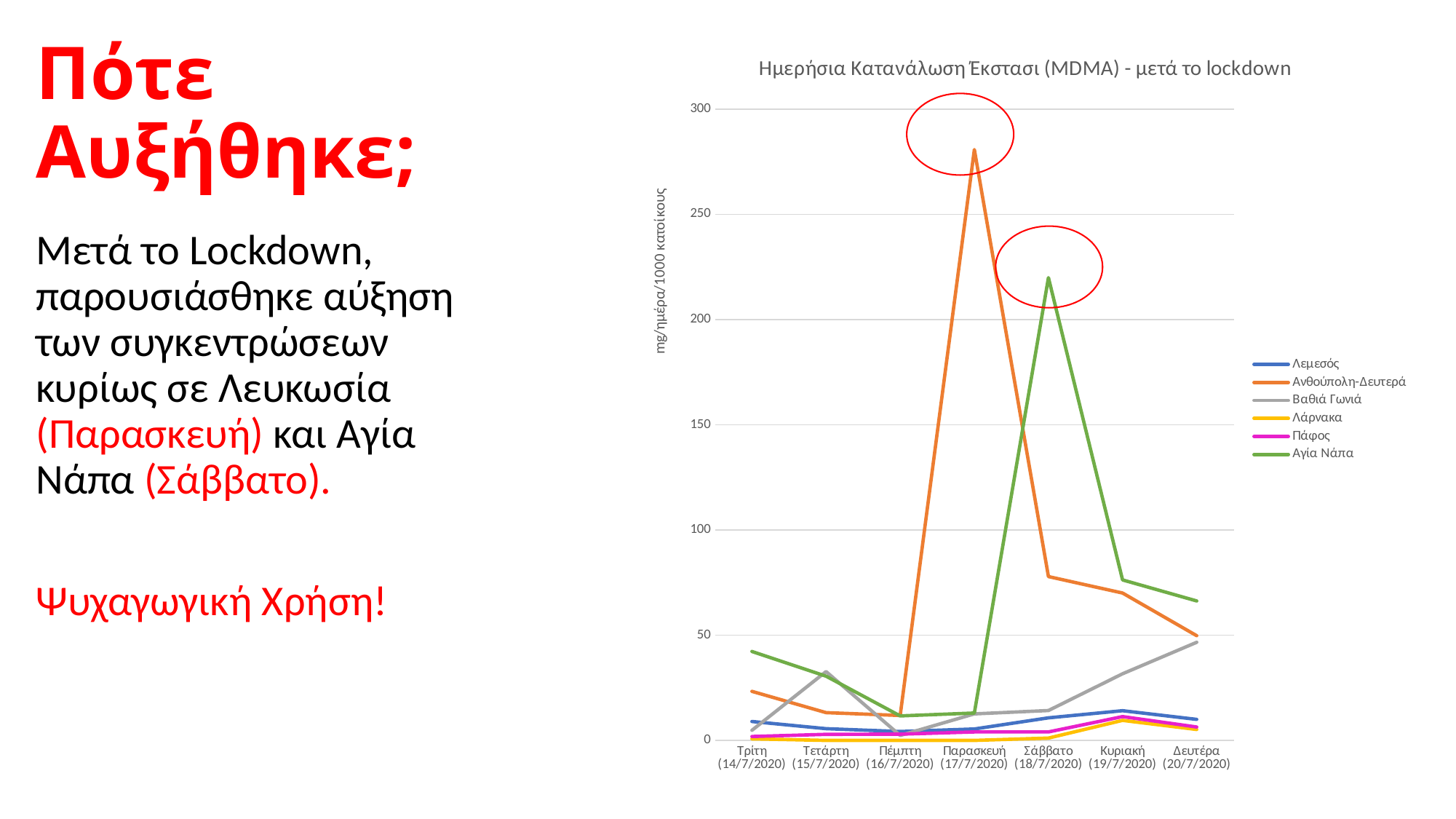
On which day does the Αγία Νάπα series reach its peak? Σάββατο (18/7/2020) What is the title of the chart? Ημερήσια Κατανάλωση Έκστασι (MDMA) - μετά το lockdown Is the value for Ανθούπολη-Δευτερά on Κυριακή (19/7/2020) greater or less than 50? greater Does the Ανθούπολη-Δευτερά series rise or fall from Παρασκευή (17/7/2020) to Δευτέρα (20/7/2020)? fall Which series reaches the highest value on the chart? Ανθούπολη-Δευτερά On Σάββατο (18/7/2020), which is larger: Αγία Νάπα or Ανθούπολη-Δευτερά? Αγία Νάπα Is the value for Ανθούπολη-Δευτερά on Παρασκευή (17/7/2020) greater or less than 250? greater How many days are shown along the x axis? 7 Is the value for Αγία Νάπα on Σάββατο (18/7/2020) greater or less than 200? greater On which day does the Ανθούπολη-Δευτερά series reach its peak? Παρασκευή (17/7/2020) How many series does the legend list? 6 What kind of chart is shown on the slide? line chart